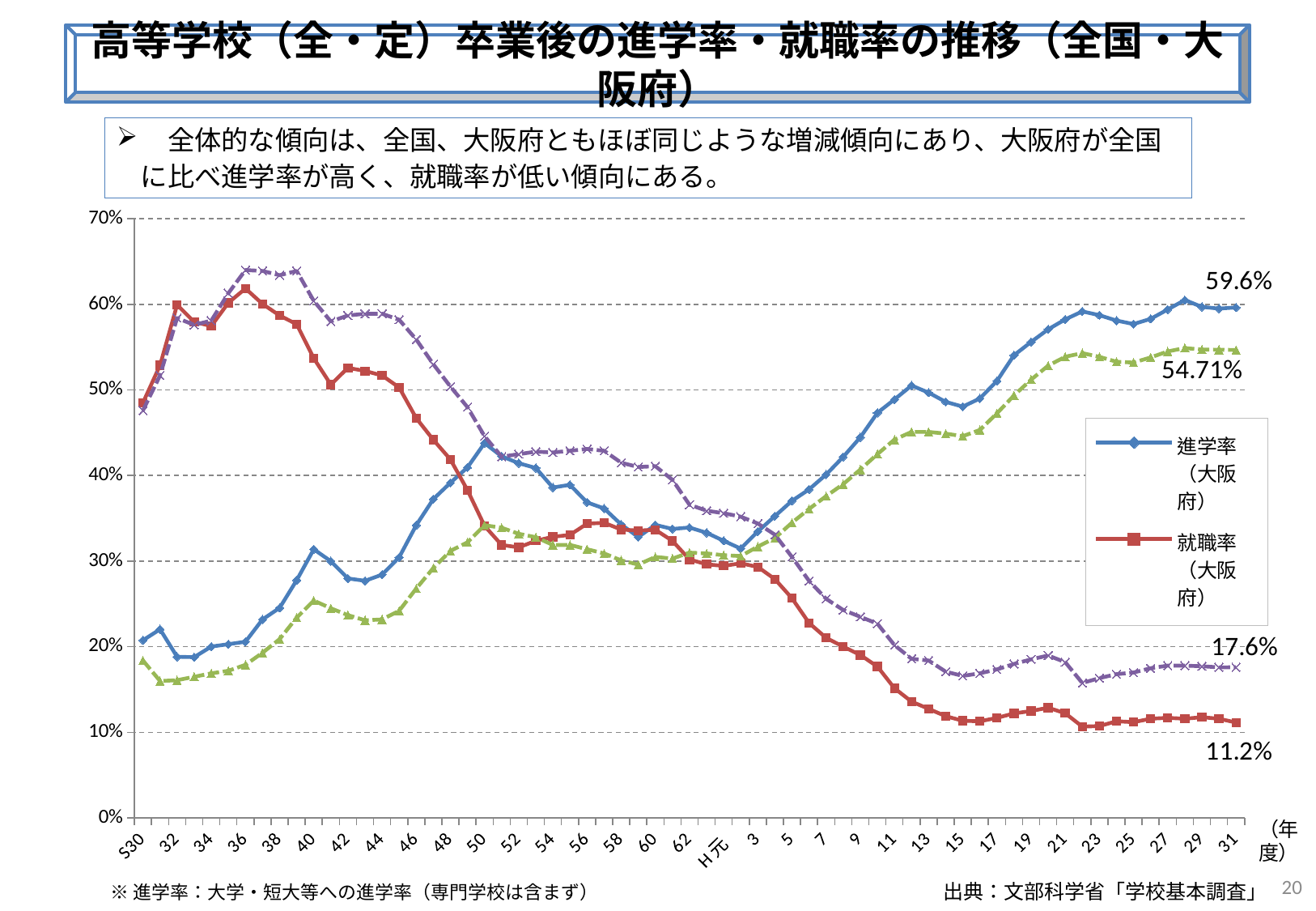
What is the first label on the chart's horizontal axis? S30 Is the value of 就職率（大阪府） at S32 greater or less than 50%? greater What is the difference between the labeled H31 values of 進学率（大阪府） (59.6%) and 就職率（大阪府） (11.2%)? 48.4 percentage points At H31, which is larger: 進学率（大阪府） or 就職率（大阪府）? 進学率（大阪府） What is the value labeled at the end of the 進学率（大阪府） line (H31)? 59.6% What is the value labeled at the end of the 就職率（大阪府） line (H31)? 11.2% Does the 進学率（大阪府） line rise or fall from H3 to H31? rise Is the value of 進学率（大阪府） at S30 greater or less than 30%? less Does the 就職率（大阪府） line rise or fall from H元 to H31? fall How many series does the chart's legend list? 2 What is the highest value shown on the chart's vertical axis? 70% What kind of chart is shown on the slide? line chart